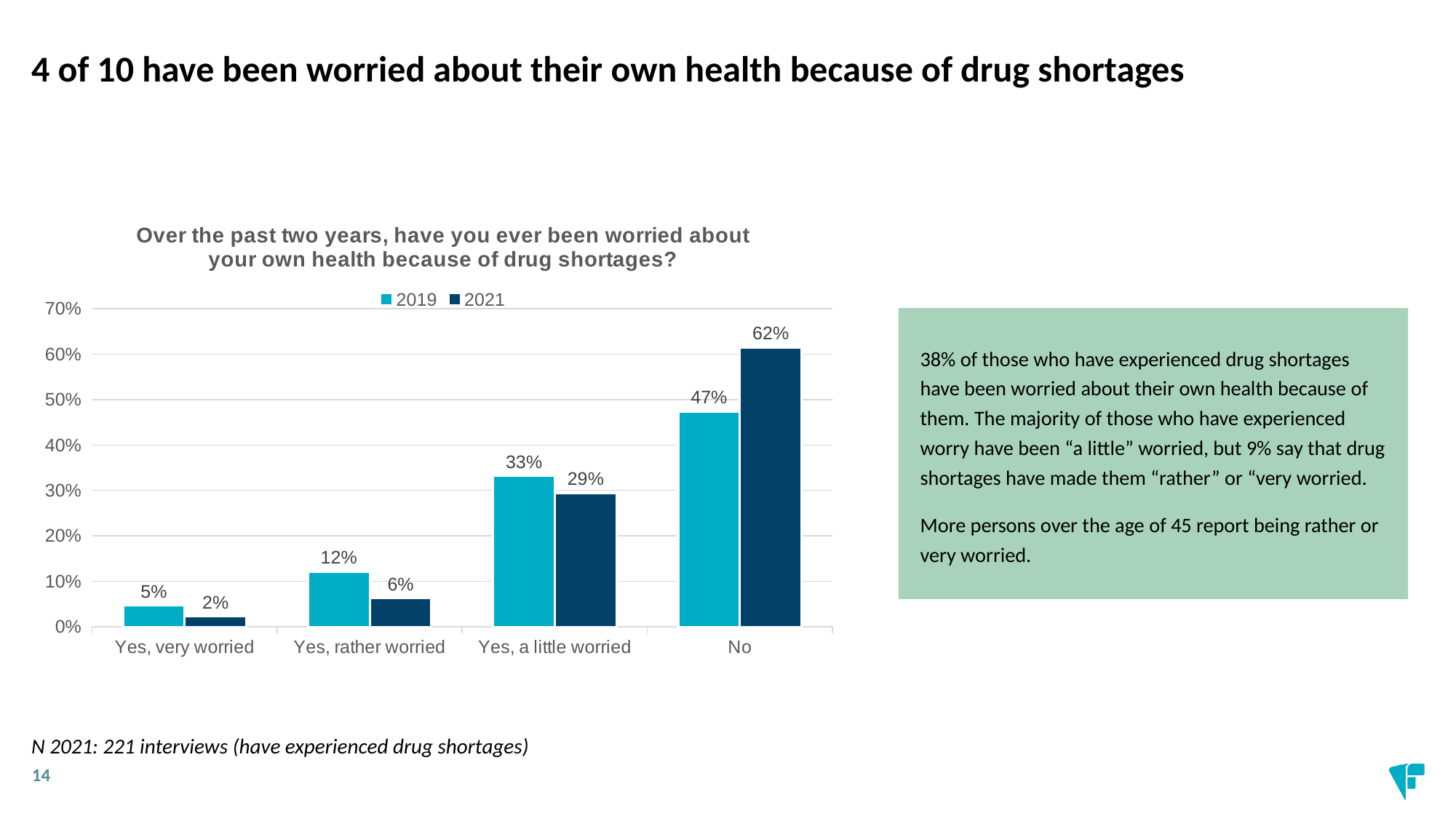
What is the 2021 value for "Yes, rather worried"? 6% Which is larger for "Yes, a little worried": the 2019 value or the 2021 value? 2019 What is the 2019 value for "Yes, a little worried"? 33% Which category has the highest 2021 value? No Which category has the lowest 2019 value? Yes, very worried What kind of chart is shown on the slide? Bar chart What is the 2021 value for "No"? 62% How many series does the legend list? 2 What is the difference between the 2021 and 2019 values for "No"? 15% What is the difference between the 2019 and 2021 values for "Yes, rather worried"? 6% How many categories are shown on the x axis? 4 Which series is shown in the darker blue colour? 2021